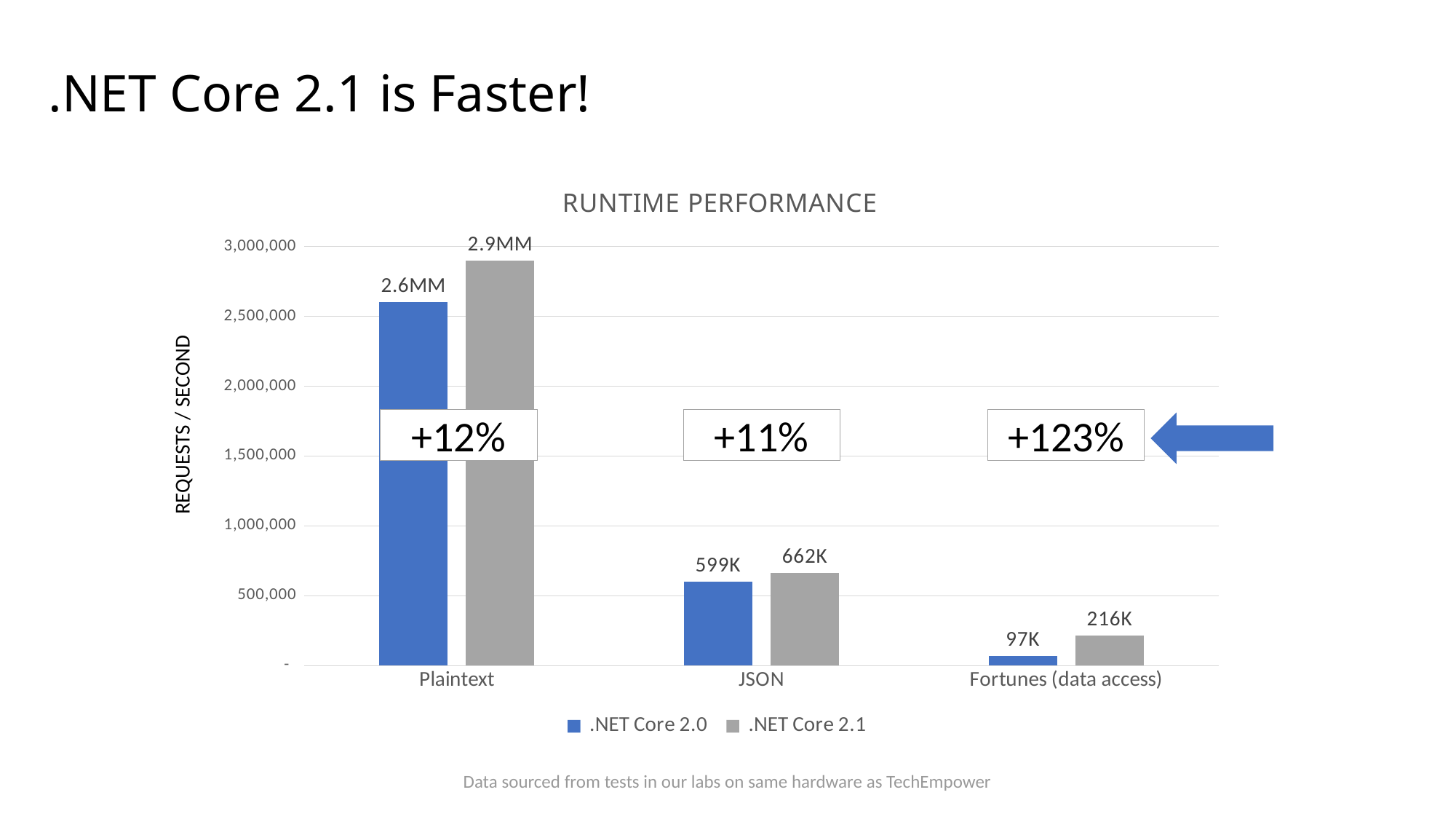
How many categories are shown on the x axis? 3 What is the difference between the .NET Core 2.1 and .NET Core 2.0 values in the JSON category? 63K What kind of chart is shown on the slide? Bar chart What is the value for .NET Core 2.1 in the Fortunes (data access) category? 216K What is the value for .NET Core 2.0 in the Fortunes (data access) category? 97K Is the value for .NET Core 2.0 in the Plaintext category greater or less than 2,000,000? greater Which category has the highest value for .NET Core 2.1? Plaintext Which is larger in the Fortunes (data access) category: .NET Core 2.0 or .NET Core 2.1? .NET Core 2.1 How many series does the legend list? 2 What is the value for .NET Core 2.1 in the Plaintext category? 2.9MM Which category has the lowest value for .NET Core 2.0? Fortunes (data access) What is the value for .NET Core 2.0 in the JSON category? 599K